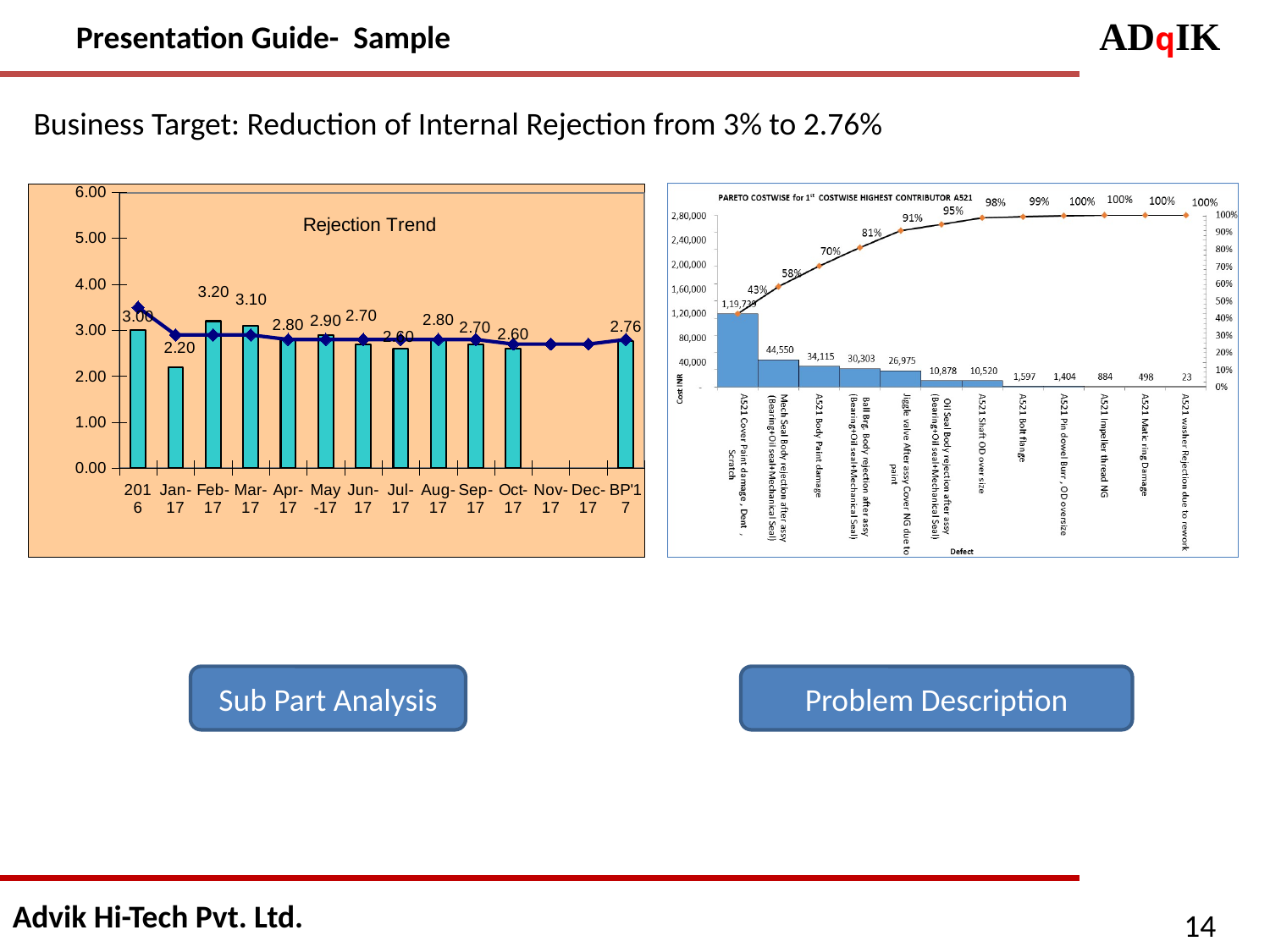
In the Rejection Trend chart, which is larger, the value for Apr-17 or the value for Jun-17? Apr-17 In the Rejection Trend chart, what is the difference between the Feb-17 and Mar-17 values? 0.10 In the Pareto chart on the right, what is the cost for A521 Shaft OD over size? 10,520 In the Rejection Trend chart, what is the rejection value for Feb-17? 3.20 In the Rejection Trend chart, which month has the lowest rejection value? Jan-17 In the Rejection Trend chart, how many categories are shown on the x axis? 14 In the Pareto chart on the right, what is the difference between the cost for Mech Seal Body rejection after assy (44,550) and A521 Body Paint damage (34,115)? 10,435 In the Rejection Trend chart, what is the rejection value for Jan-17? 2.20 In the Rejection Trend chart, what is the value shown for BP'17? 2.76 In the Pareto chart on the right, which defect has the lowest cost? A521 washer Rejection due to rework In the Rejection Trend chart, which month has the highest rejection value? Feb-17 In the Pareto chart on the right, what cumulative percentage is shown at A521 Body Paint damage? 70%